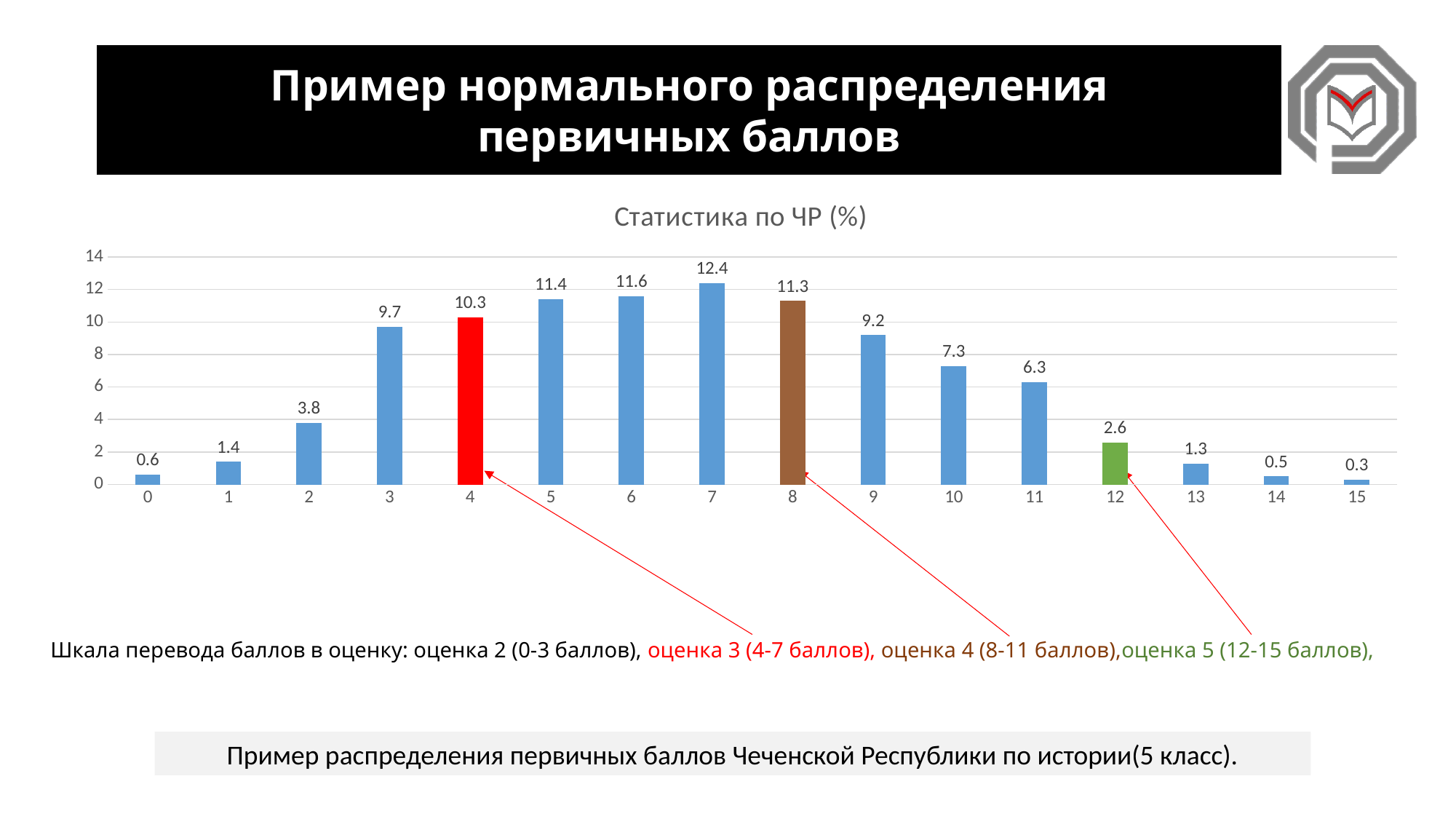
What is the difference between the values for score 3 and score 2? 5.9 What is the value for score 12 in the chart? 2.6 Which score has the highest value in the chart? 7 Do the values rise or fall from score 8 to score 15? fall What is the difference between the values for score 7 and score 8? 1.1 What is the value for score 7 in the chart? 12.4 How many score categories are shown on the x axis of the chart? 16 What kind of chart is shown on the slide? bar chart Which is larger, the value for score 5 or the value for score 9? score 5 Which score has the lowest value in the chart? 15 What is the title of the chart? Статистика по ЧР (%) What is the value for score 0 in the chart? 0.6